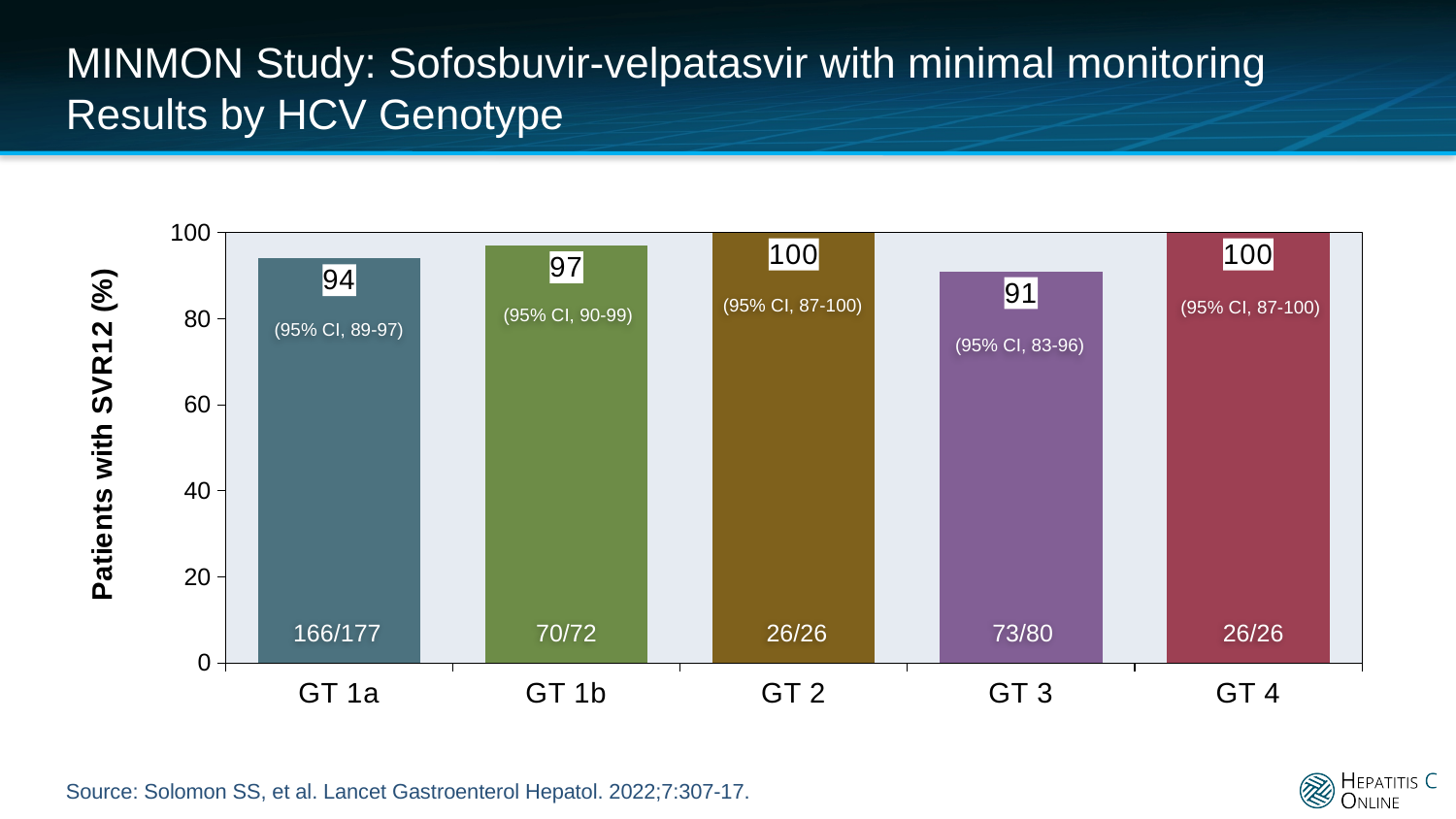
What kind of chart is shown on the slide? Bar chart What is the SVR12 rate for GT 1b? 97 What is the SVR12 rate for GT 3? 91 How many genotype categories are shown on the x axis? 5 What is the difference in SVR12 rate between GT 1b and GT 3? 6 How many patients achieved SVR12 out of the total for GT 1a? 166/177 Is the value for GT 3 greater or less than 80? greater Which has a higher SVR12 rate, GT 1a or GT 1b? GT 1b Which genotype has the lowest SVR12 rate? GT 3 What is the label on the y axis? Patients with SVR12 (%) What is the 95% confidence interval shown for GT 3? (95% CI, 83-96) What is the SVR12 rate for GT 1a? 94